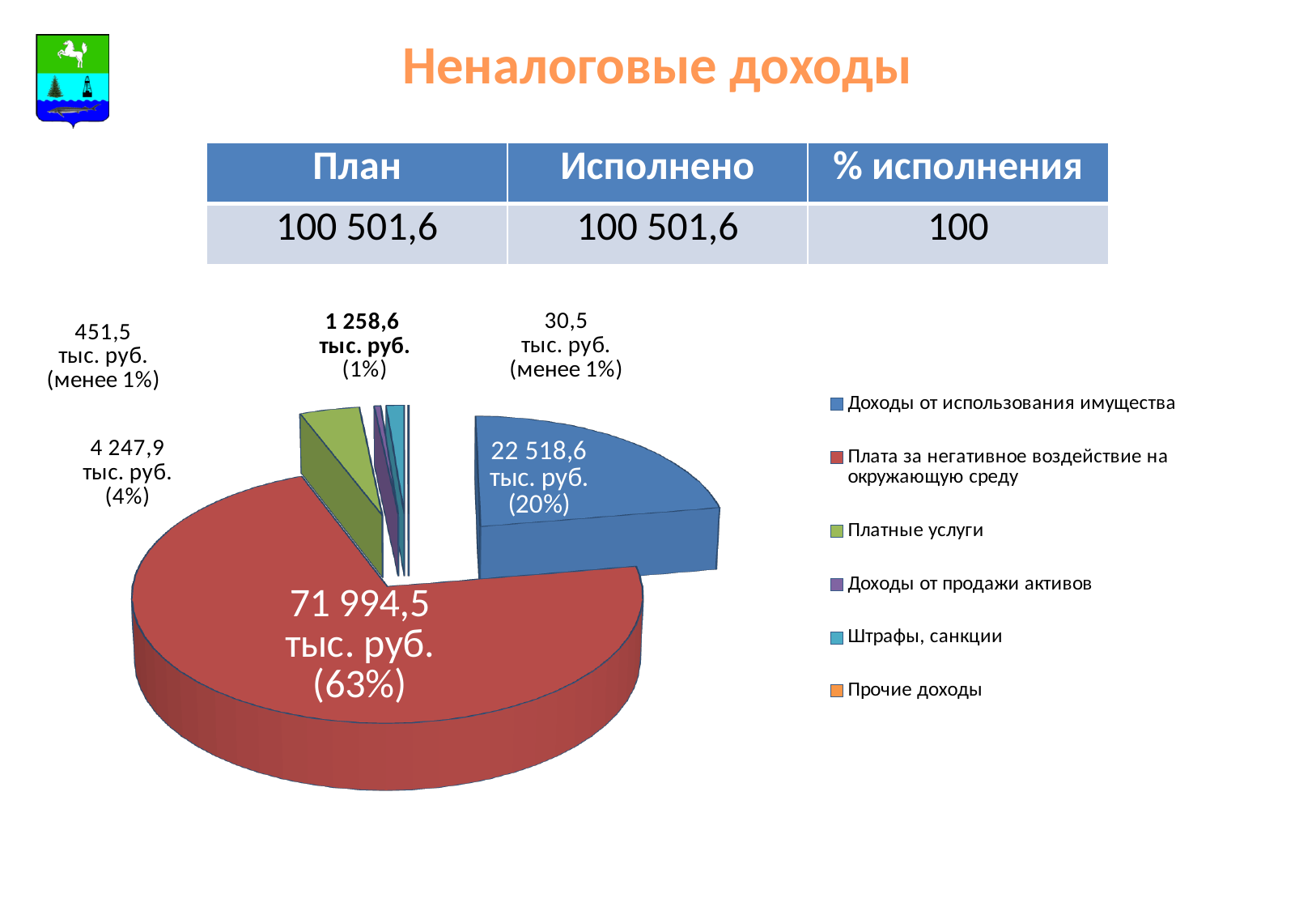
How many categories does the legend of the pie chart list? 6 What is the value shown for Плата за негативное воздействие на окружающую среду? 71 994,5 тыс. руб. What colour is the largest slice of the pie? red What is the value shown for Доходы от использования имущества? 22 518,6 тыс. руб. What share of the pie does Плата за негативное воздействие на окружающую среду represent? 63% What is the value shown for Платные услуги? 4 247,9 тыс. руб. Which is larger, Платные услуги or Доходы от продажи активов? Платные услуги What is the value shown for Доходы от продажи активов? 451,5 тыс. руб. Which category has the largest slice of the pie? Плата за негативное воздействие на окружающую среду What kind of chart is shown on the slide? pie chart What is the difference between the values for Плата за негативное воздействие на окружающую среду and Доходы от использования имущества? 49 475,9 тыс. руб. What share of the pie does Доходы от использования имущества represent? 20%